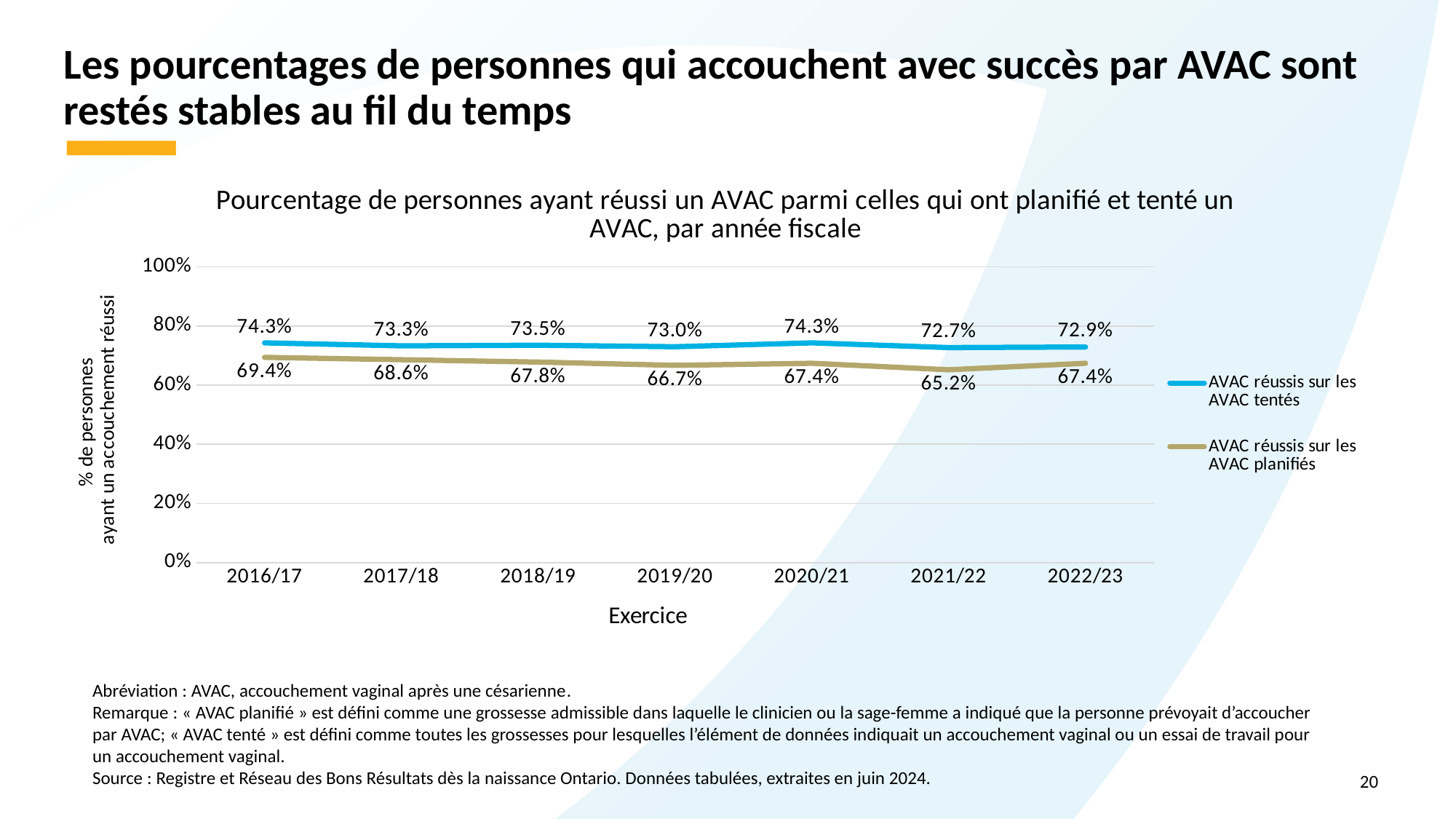
What is the difference between 'AVAC réussis sur les AVAC tentés' and 'AVAC réussis sur les AVAC planifiés' in 2022/23? 5.5% Which series has the higher value in 2020/21, 'AVAC réussis sur les AVAC tentés' or 'AVAC réussis sur les AVAC planifiés'? AVAC réussis sur les AVAC tentés What is the value for 'AVAC réussis sur les AVAC planifiés' in 2021/22? 65.2% What type of chart is shown on the slide? line chart How many fiscal years are plotted on the x axis? 7 Is the value for 'AVAC réussis sur les AVAC tentés' in 2018/19 greater or less than 80%? less What is the label of the x axis? Exercice What is the value for 'AVAC réussis sur les AVAC planifiés' in 2016/17? 69.4% In which fiscal year is 'AVAC réussis sur les AVAC planifiés' lowest? 2021/22 In which fiscal year is 'AVAC réussis sur les AVAC planifiés' highest? 2016/17 What is the value for 'AVAC réussis sur les AVAC tentés' in 2019/20? 73.0% How many series does the legend list? 2